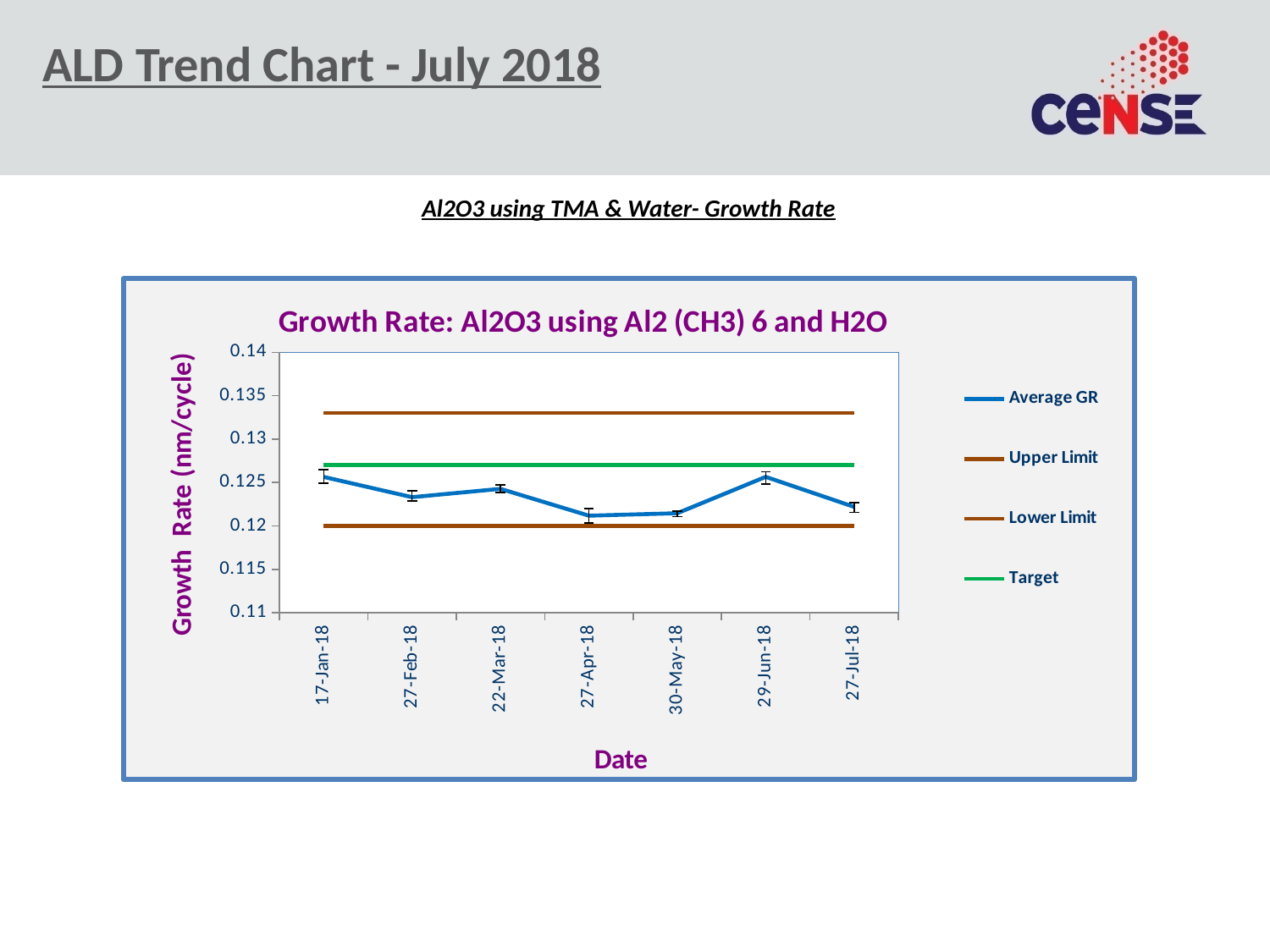
Is the Average GR value for 27-Apr-18 greater or less than 0.125? less Which has the larger Average GR value, 22-Mar-18 or 27-Apr-18? 22-Mar-18 Is the Target value greater or less than 0.13? less What kind of chart is shown on the slide? line chart How many dates are plotted along the x axis of the chart? 7 How many series does the chart legend list? 4 Is the Upper Limit value greater or less than 0.13? greater What colour is the Target line in the chart? green Does the Average GR rise or fall from 30-May-18 to 29-Jun-18? rise Which has the larger Average GR value, 27-Feb-18 or 29-Jun-18? 29-Jun-18 What is the title of the chart? Growth Rate: Al2O3 using Al2 (CH3) 6 and H2O